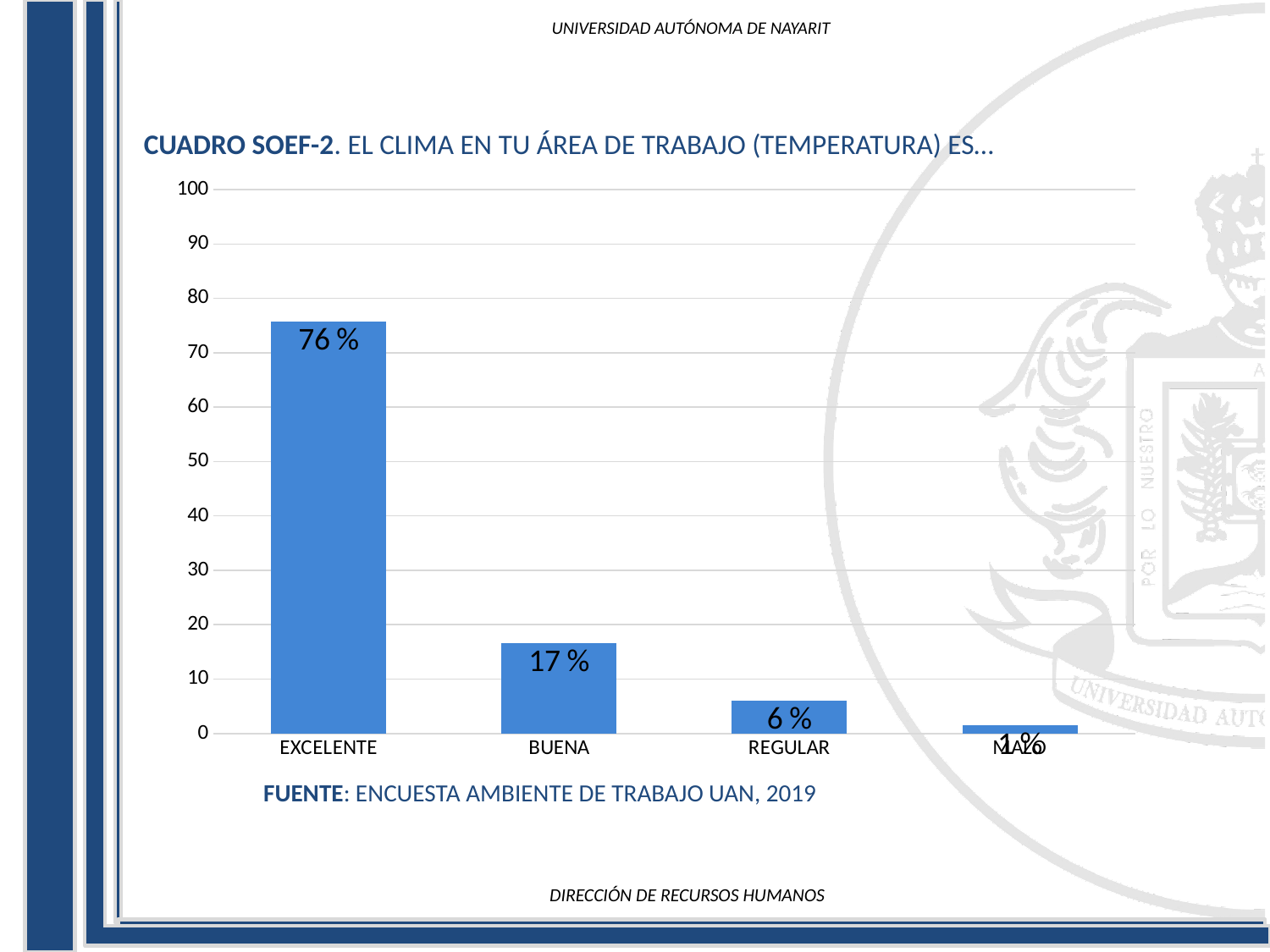
How many categories are shown on the x axis? 4 What is the difference between the values for EXCELENTE and BUENA? 59 % Is the value for EXCELENTE greater or less than 70? greater Which category has the lowest value? MALO What is the value for EXCELENTE? 76 % Which category has the highest value? EXCELENTE What is the difference between the values for BUENA and REGULAR? 11 % Which is larger, the value for BUENA or the value for REGULAR? BUENA Do the values rise or fall from left to right along the x axis? fall What is the value for BUENA? 17 % What is the value for REGULAR? 6 % What kind of chart is shown on the slide? bar chart